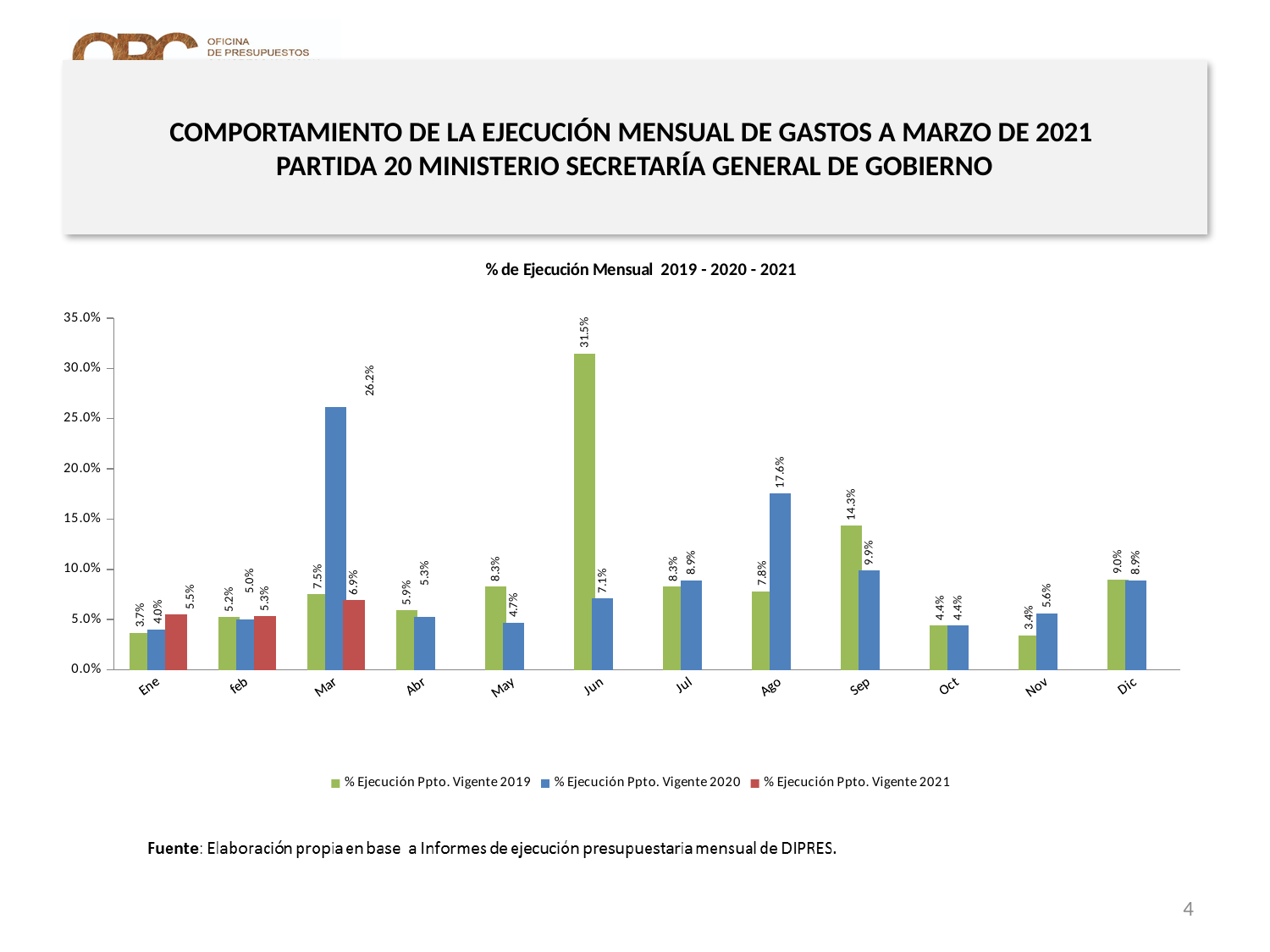
What is the difference between the 2020 and 2019 values in Mar? 18.7% What kind of chart is shown on the slide? Bar chart What is the value for % Ejecución Ppto. Vigente 2021 in Ene? 5.5% In which month is the % Ejecución Ppto. Vigente 2019 series highest? Jun What is the title of the chart? % de Ejecución Mensual 2019 - 2020 - 2021 In which month is the % Ejecución Ppto. Vigente 2019 series lowest? Nov What is the value for % Ejecución Ppto. Vigente 2019 in Jun? 31.5% How many months are shown on the x axis? 12 Which is larger in Sep: the 2019 value or the 2020 value? 2019 (14.3%) What is the value for % Ejecución Ppto. Vigente 2020 in Ago? 17.6% How many series does the legend list? 3 What is the value for % Ejecución Ppto. Vigente 2020 in Mar? 26.2%